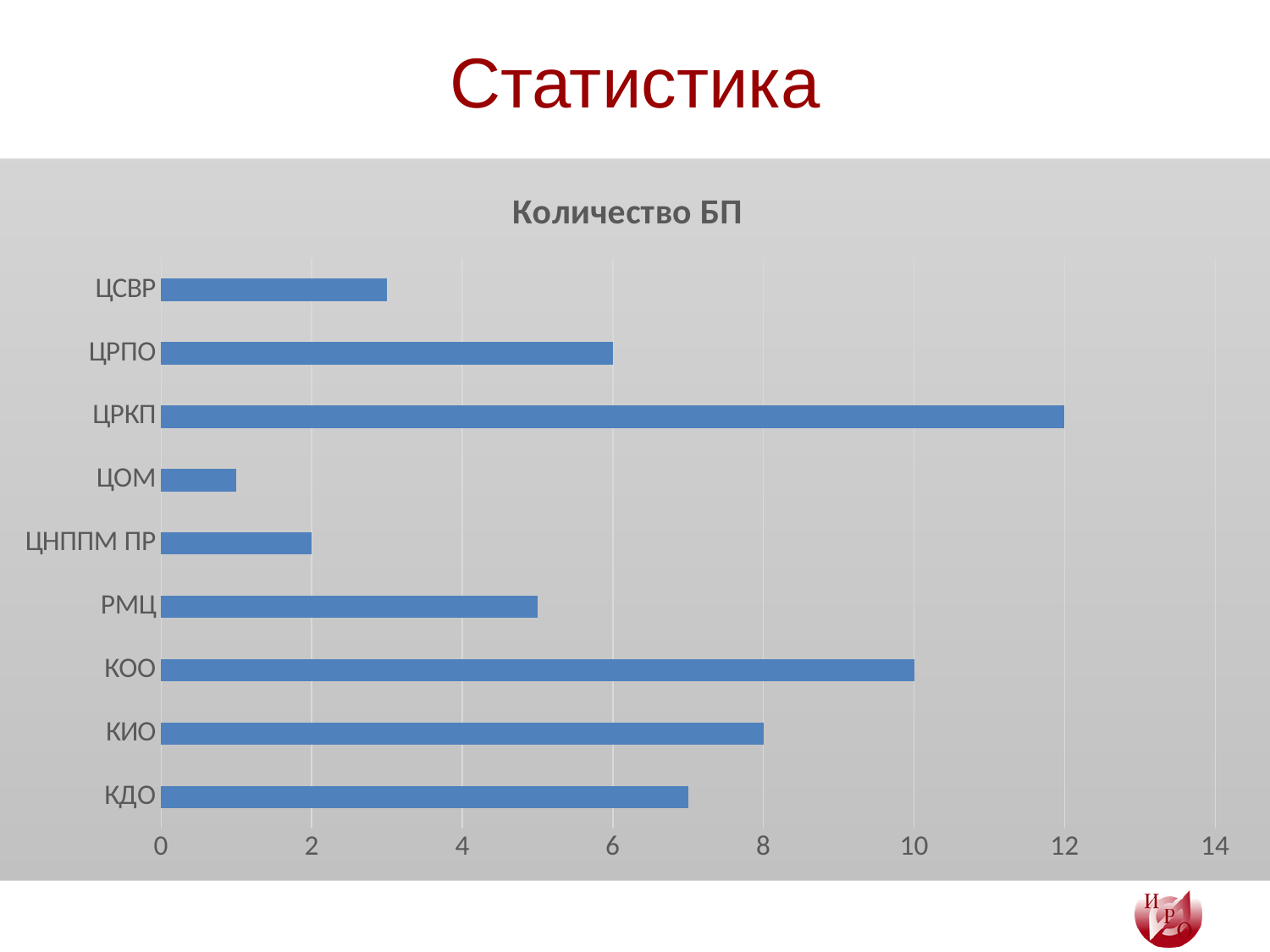
Which category has the highest value? ЦРКП What is the value for ЦРКП? 12 How many categories are shown in the chart? 9 Is the value for ЦСВР greater or less than 4? less What is the value for КИО? 8 Which category has the lowest value? ЦОМ What is the value for КОО? 10 What is the value for ЦРПО? 6 What is the difference between the values for ЦРКП and КОО? 2 What kind of chart is shown on the slide? bar chart Which is larger, the value for КДО or the value for РМЦ? КДО What is the title of the chart? Количество БП